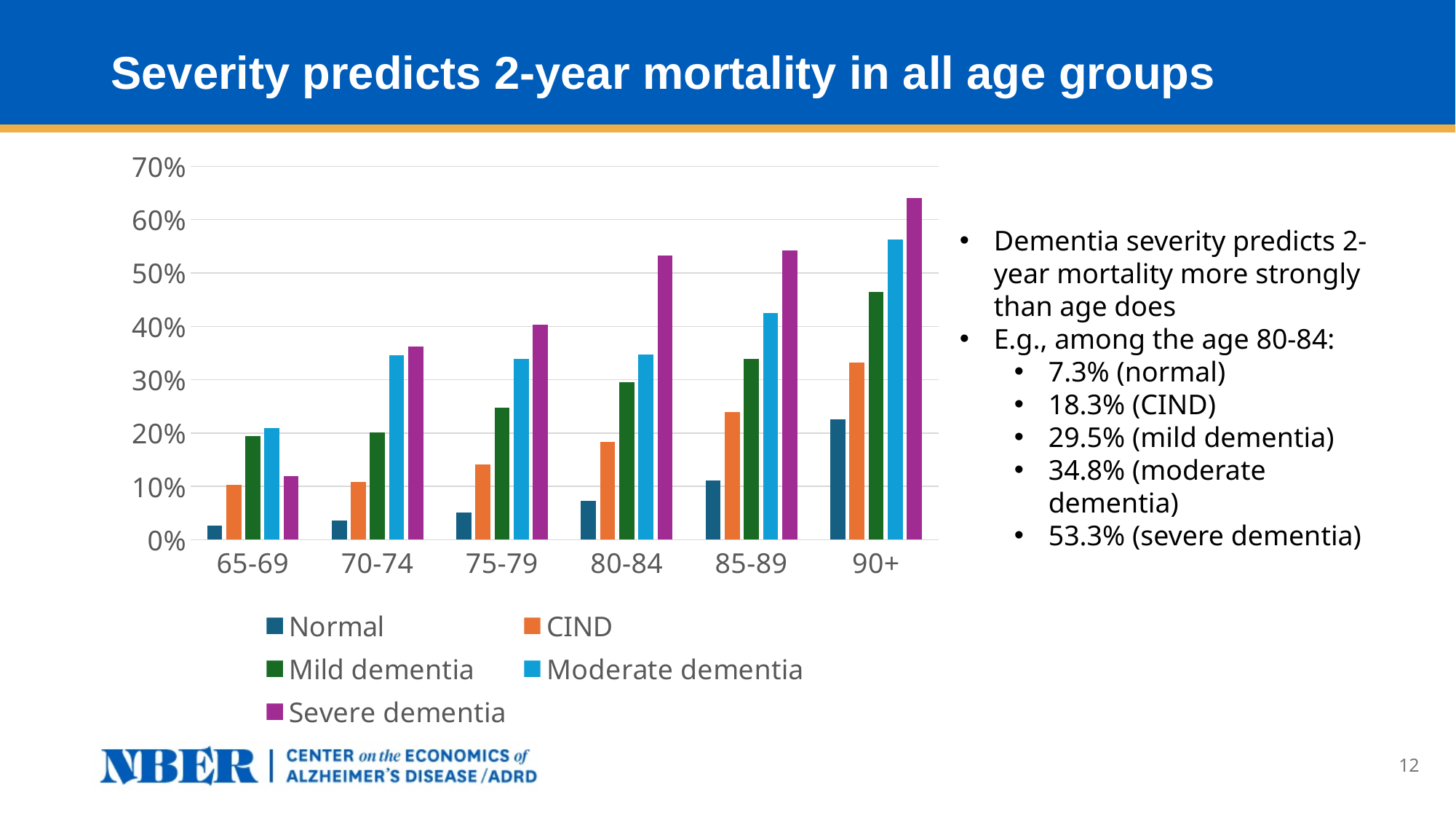
What is the 2-year mortality for the Normal group among ages 80-84? 7.3% In the 65-69 age group, which is larger: the Moderate dementia bar or the Severe dementia bar? Moderate dementia Which series has the lowest bar in the 65-69 age group? Normal How many series does the legend list? 5 What kind of chart is shown on the slide? bar chart Do the Normal series bars rise or fall as age increases along the x axis? rise Among ages 80-84, what is the difference between the Moderate dementia and Mild dementia mortality values? 5.3% Which age group has the highest Severe dementia bar? 90+ What is the 2-year mortality for Severe dementia among ages 80-84? 53.3% How many age groups are shown on the x axis? 6 Among ages 80-84, what is the difference between the Severe dementia and Normal mortality values? 46.0% Is the Moderate dementia value for the 90+ age group greater or less than 50%? greater